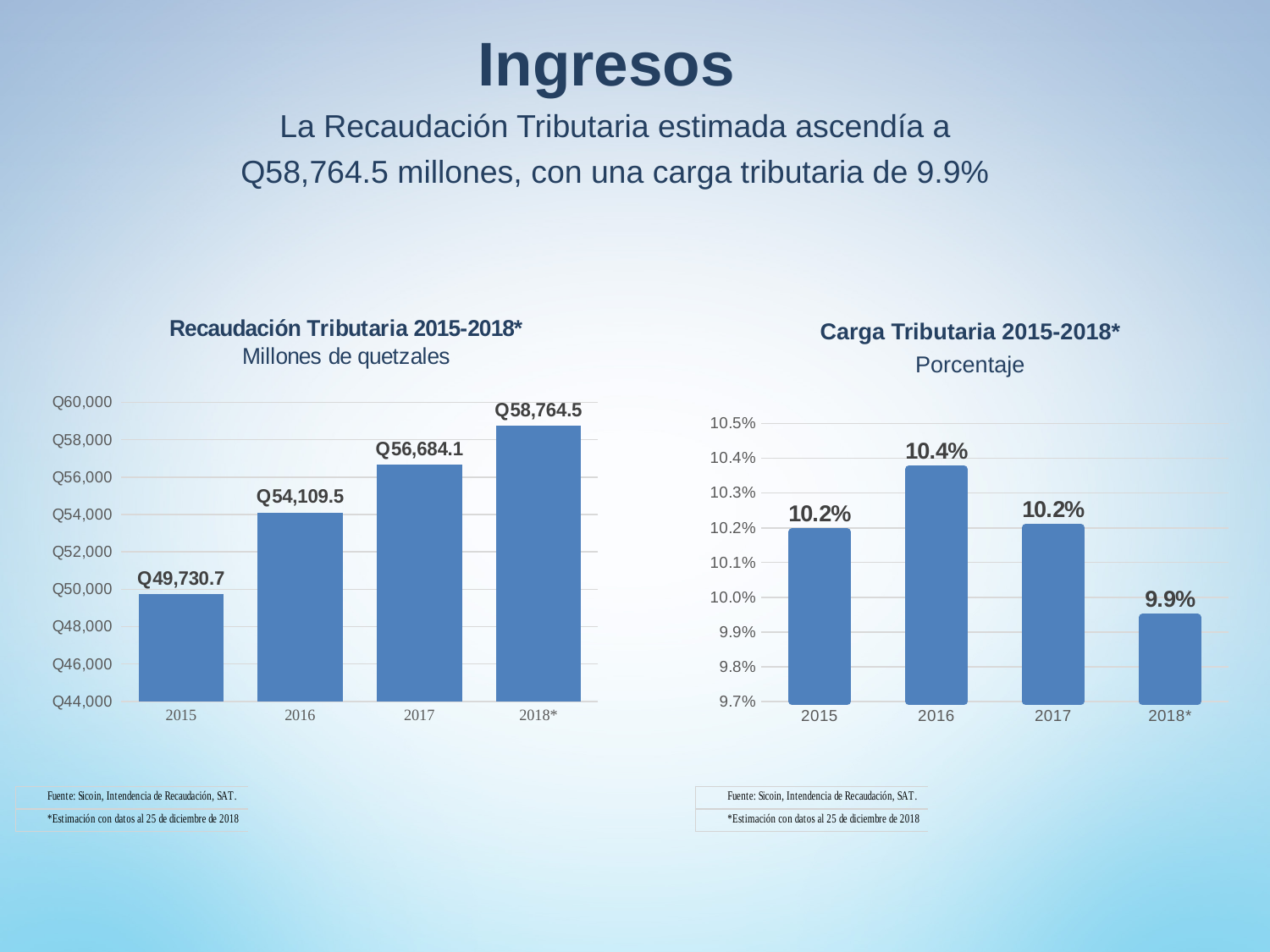
In the 'Recaudación Tributaria 2015-2018*' chart, do the values rise or fall from 2015 to 2018*? rise In the 'Recaudación Tributaria 2015-2018*' chart, how many years are shown? 4 In the 'Recaudación Tributaria 2015-2018*' chart, what is the value for 2016? Q54,109.5 In the 'Carga Tributaria 2015-2018*' chart, what is the value for 2016? 10.4% What unit is stated in the subtitle of the 'Recaudación Tributaria 2015-2018*' chart? Millones de quetzales In the 'Recaudación Tributaria 2015-2018*' chart, which year has the lowest value? 2015 What kind of chart is the 'Carga Tributaria 2015-2018*' chart? bar chart In the 'Recaudación Tributaria 2015-2018*' chart, what is the value for 2018*? Q58,764.5 In the 'Carga Tributaria 2015-2018*' chart, what is the value for 2018*? 9.9% In the 'Carga Tributaria 2015-2018*' chart, which is larger, the value for 2016 or the value for 2018*? 2016 In the 'Recaudación Tributaria 2015-2018*' chart, what is the difference between the 2018* and 2015 values? Q9,033.8 In the 'Carga Tributaria 2015-2018*' chart, which year has the highest value? 2016